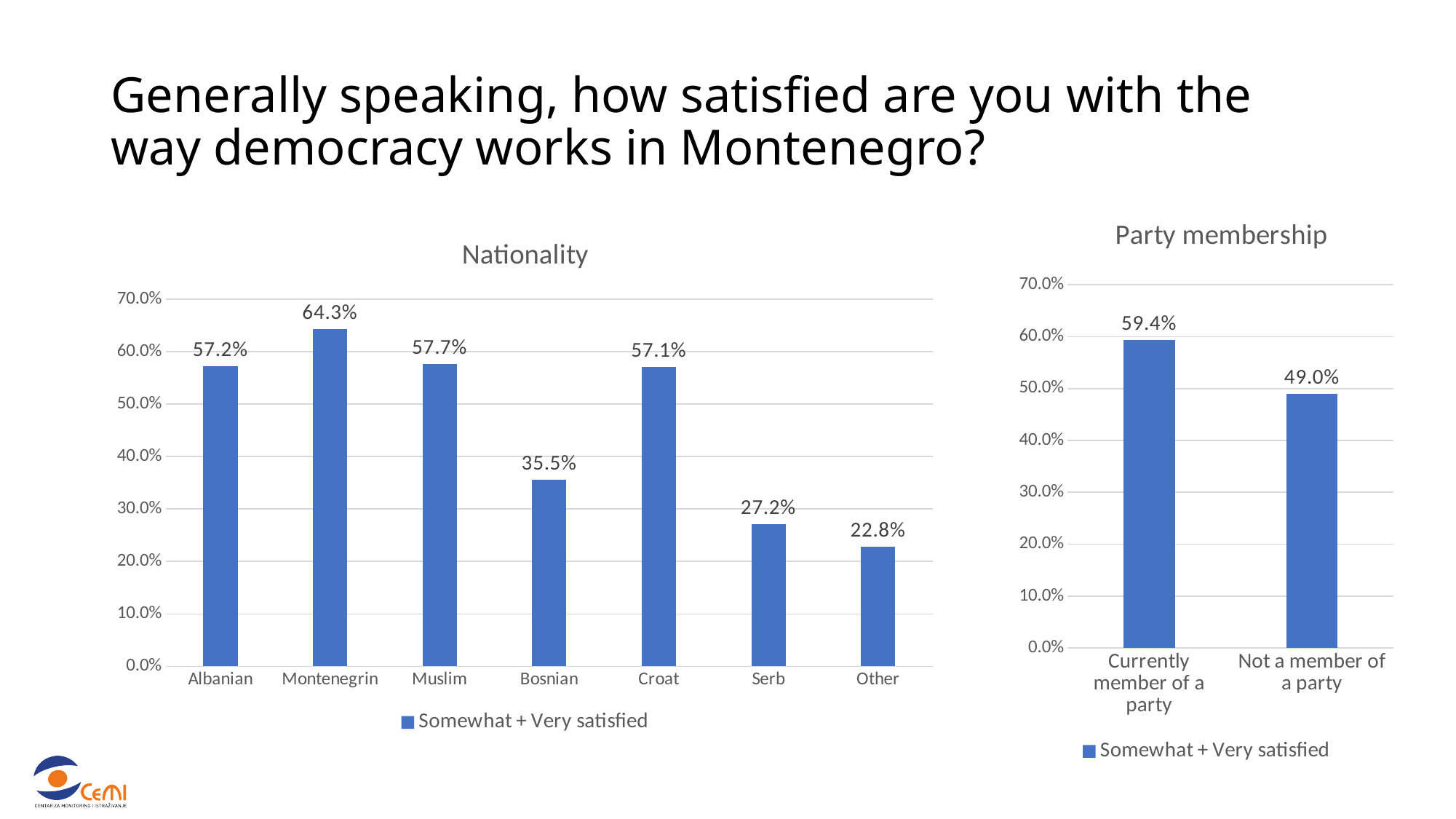
In the Nationality chart, what is the value for Bosnian? 35.5% In the Nationality chart, which is larger, the value for Bosnian or the value for Serb? Bosnian In the Party membership chart, is the value for Currently member of a party greater or less than 50.0%? greater In the Party membership chart, what is the difference between the values for Currently member of a party and Not a member of a party? 10.4% In the Nationality chart, which nationality has the highest share of somewhat + very satisfied? Montenegrin In the Nationality chart, what is the value for Montenegrin? 64.3% What type of chart is the Nationality chart? Bar chart In the Nationality chart, which category has the lowest value? Other How many nationality categories are shown in the Nationality chart? 7 In the Party membership chart, what is the value for Not a member of a party? 49.0% How many series does the legend of the Party membership chart list? 1 In the Nationality chart, what is the difference between the values for Montenegrin and Serb? 37.1%